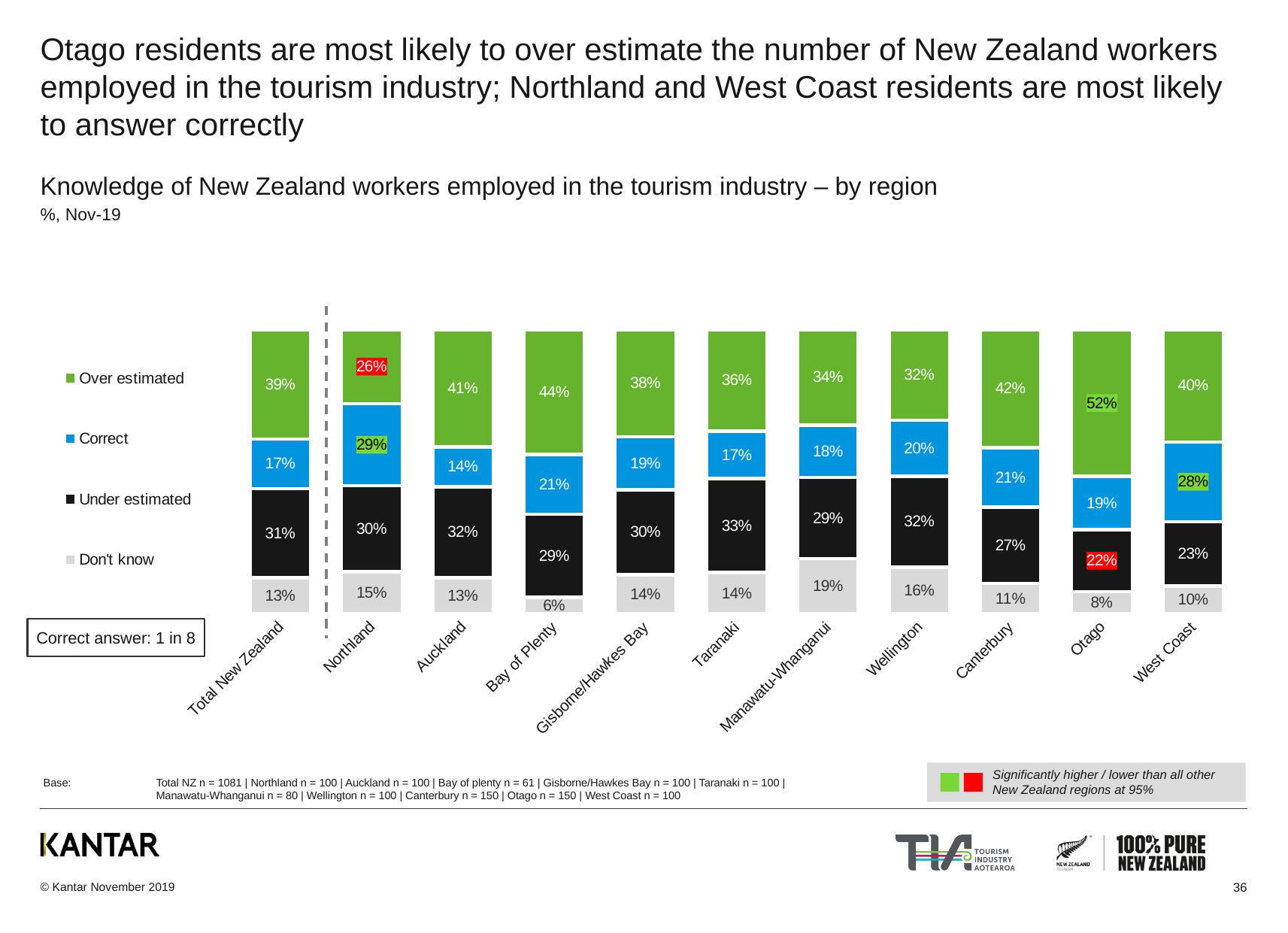
What percentage of Otago residents over estimated the number of New Zealand workers employed in the tourism industry? 52% Which has a larger 'Under estimated' value, Taranaki or Canterbury? Taranaki What percentage of Northland residents answered correctly? 29% What kind of chart is shown on the slide? Stacked bar chart Which region has the highest 'Over estimated' value? Otago What is the total of the stacked bar for Total New Zealand? 100% How many series does the legend list? 4 According to the box on the slide, what is the correct answer to the question about New Zealand workers employed in tourism? 1 in 8 What is the difference between the 'Correct' values for West Coast and Auckland? 14% What is the 'Don't know' value for Manawatu-Whanganui? 19% Which region has the lowest 'Don't know' value? Bay of Plenty How many regions (including Total New Zealand) are shown on the x axis? 11